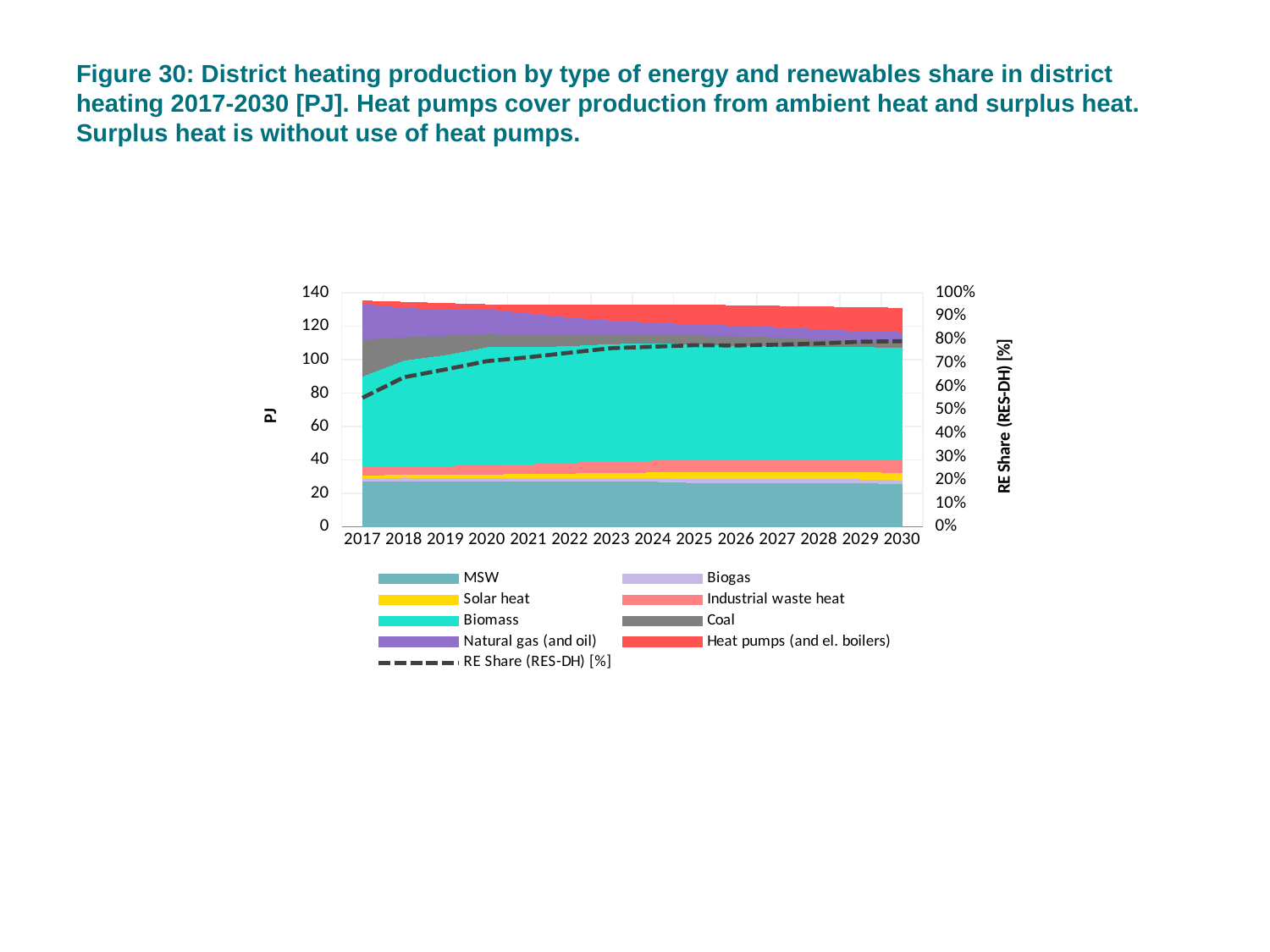
Is the RE Share (RES-DH) [%] value for 2017 greater or less than 60%? less Is the RE Share (RES-DH) [%] value for 2017 greater or less than 50%? greater How many series does the legend list? 9 Does the RE Share (RES-DH) [%] line rise or fall from 2017 to 2030? rise Does the Coal area grow or shrink over the period shown? shrink Is the total district heating production in 2017 greater or less than 120 PJ? greater What kind of chart is shown on the slide? Stacked area chart with a line What is the last year shown on the x axis? 2030 Does the Heat pumps (and el. boilers) area grow or shrink from 2017 to 2030? grow What is the first year shown on the x axis? 2017 How many years are shown along the x axis? 14